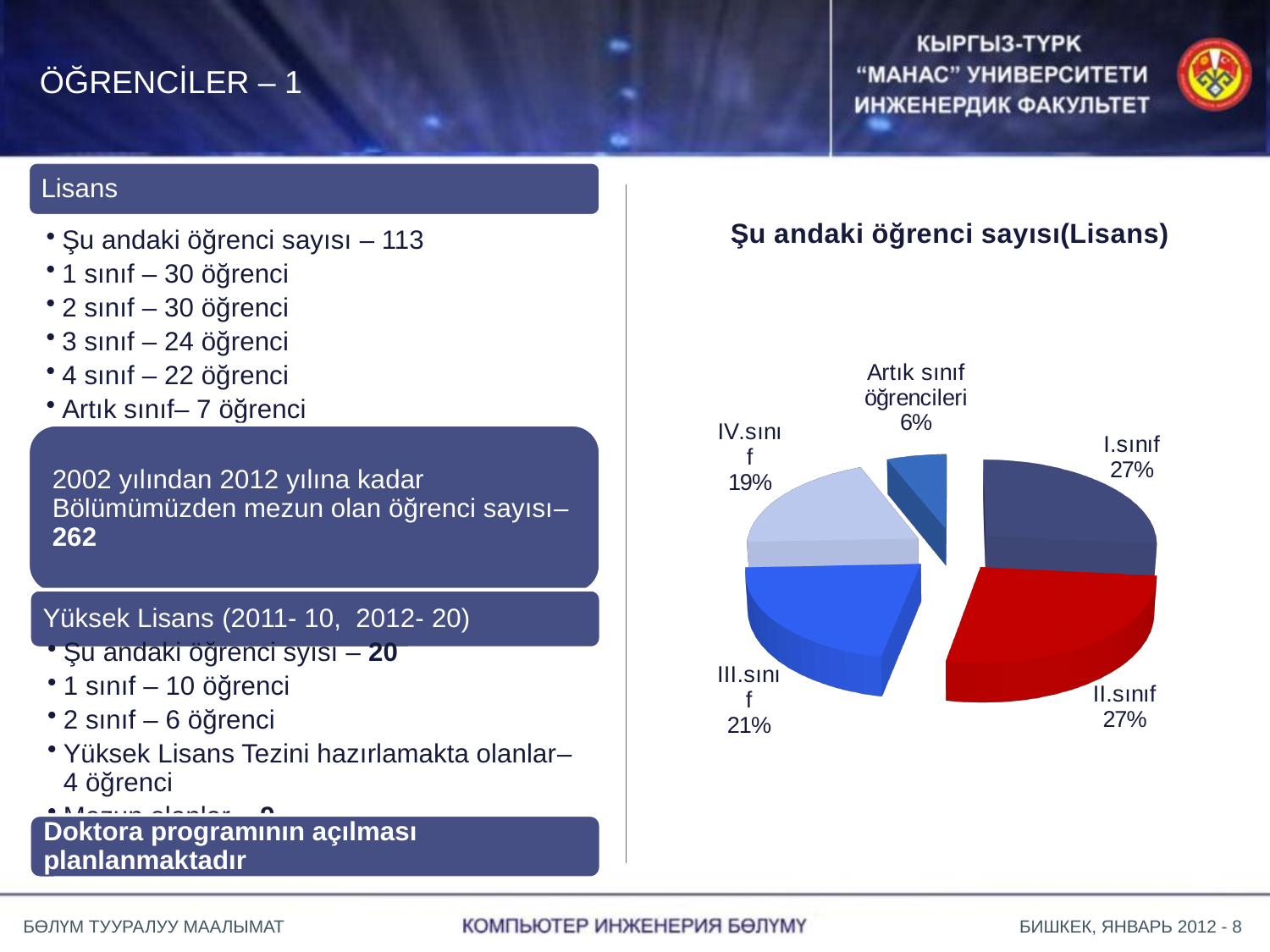
What is the title of the chart? Şu andaki öğrenci sayısı(Lisans) Which is larger, the share for III.sınıf or the share for IV.sınıf? III.sınıf What share of the pie does IV.sınıf have? 19% What is the difference in percentage points between I.sınıf and IV.sınıf? 8 Which slice of the pie is the smallest? Artık sınıf öğrencileri What percentage is shown for I.sınıf? 27% What percentage is shown for Artık sınıf öğrencileri? 6% What kind of chart is shown on the slide? pie chart How many slices does the pie chart have? 5 What is the difference in percentage points between III.sınıf and Artık sınıf öğrencileri? 15 What percentage is shown for II.sınıf? 27% What share of the pie does III.sınıf have? 21%